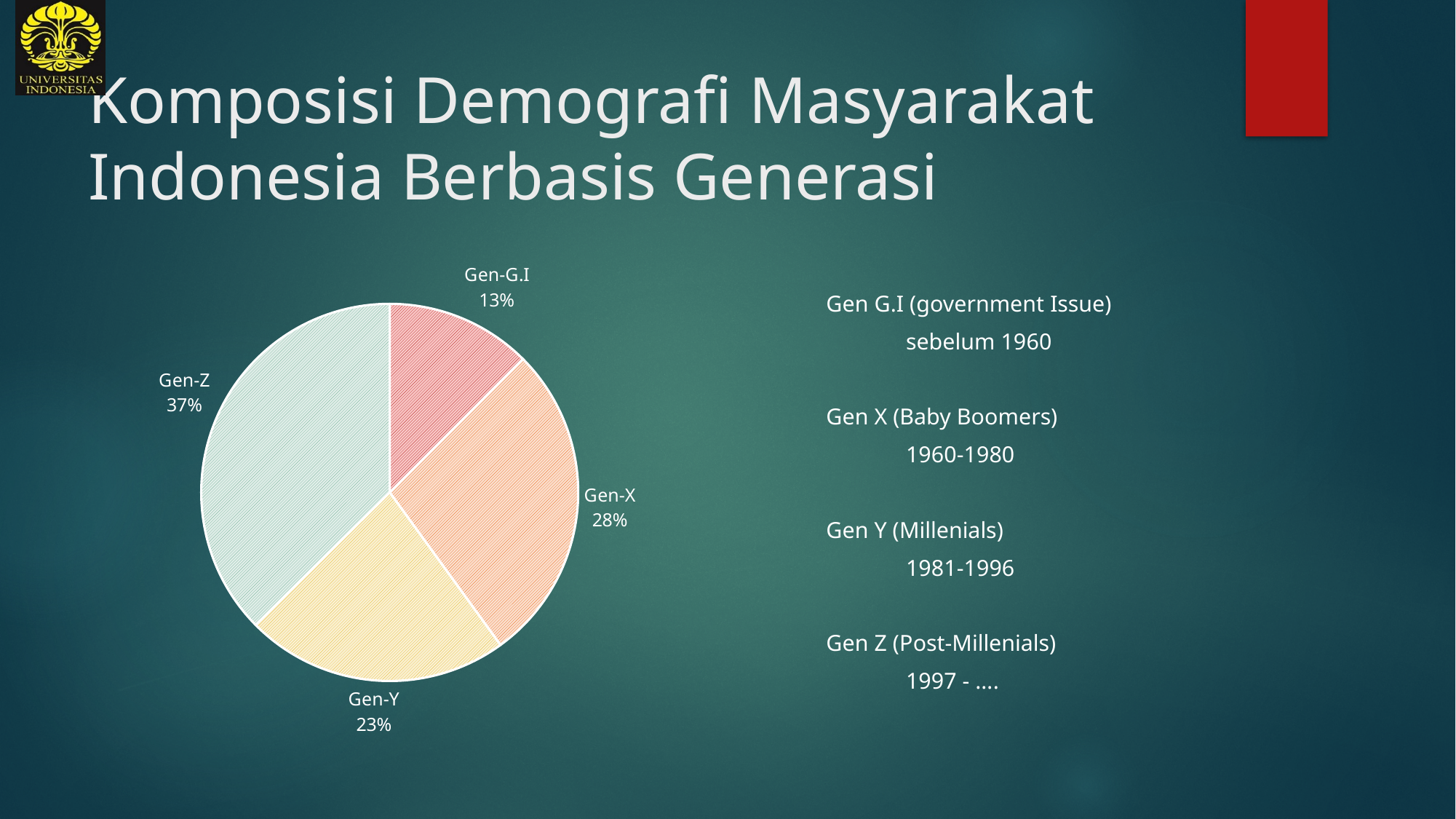
Which generation has the largest slice of the pie chart? Gen-Z How many slices does the pie chart have? 4 What percentage share does Gen-Z have in the pie chart? 37% What is the difference in percentage points between Gen-Z and Gen-G.I? 24 What percentage share does Gen-Y have in the pie chart? 23% What percentage share does Gen-G.I have in the pie chart? 13% Which slice is larger, Gen-X or Gen-Y? Gen-X What is the difference in percentage points between Gen-X and Gen-Y? 5 What percentage share does Gen-X have in the pie chart? 28% What colour is the Gen-G.I slice of the pie chart? red What kind of chart is shown on the slide? pie chart Which generation has the smallest slice of the pie chart? Gen-G.I